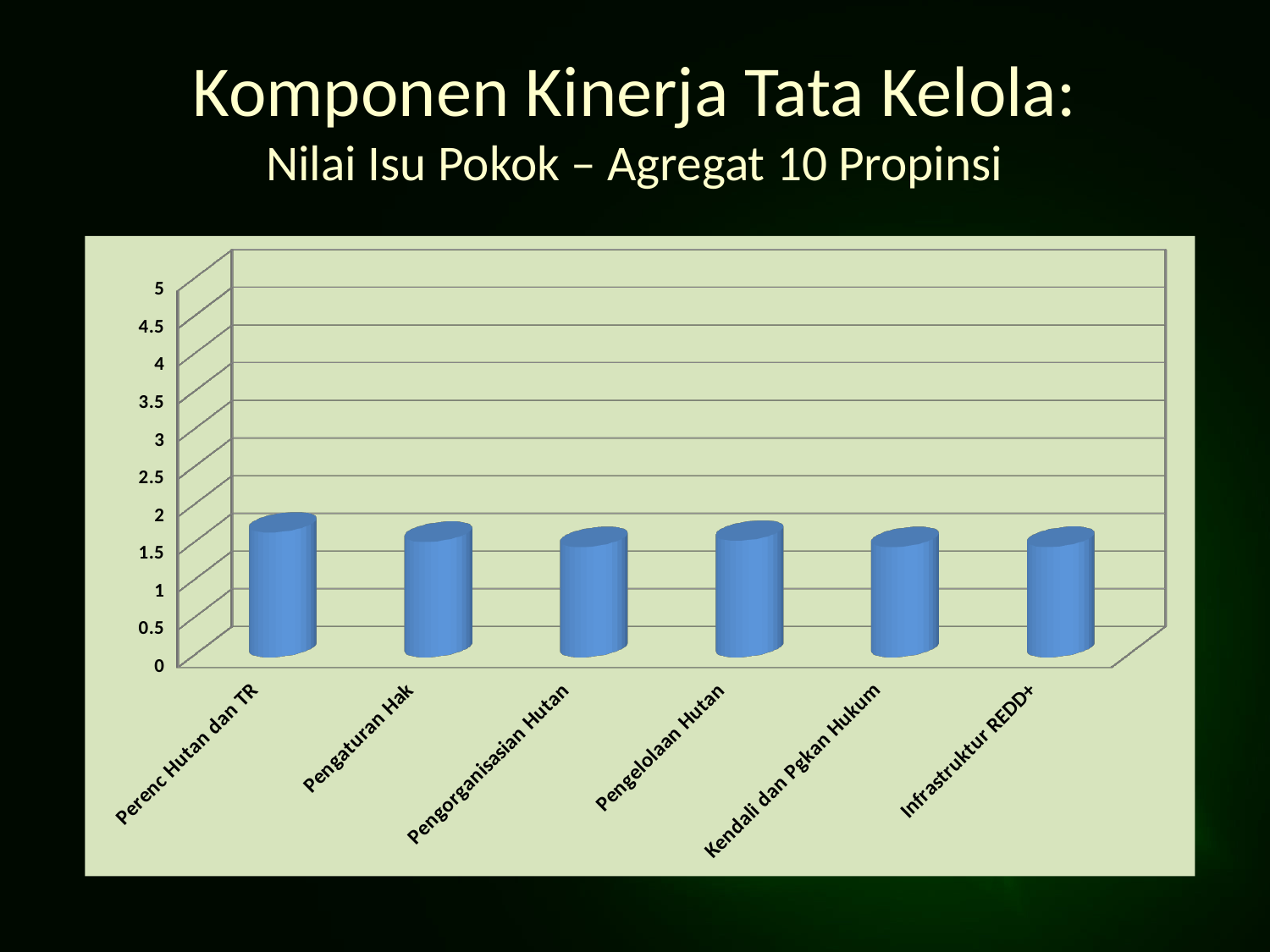
Is the value for Kendali dan Pgkan Hukum greater or less than 1? greater Which category has the highest bar in the chart? Perenc Hutan dan TR Is the value for Pengelolaan Hutan greater or less than 2? less Is the value for Infrastruktur REDD+ greater or less than 2.5? less What is the highest value shown on the vertical axis of the chart? 5 Which is larger, the value for Perenc Hutan dan TR or the value for Infrastruktur REDD+? Perenc Hutan dan TR What kind of chart is shown on the slide? bar chart How many categories are shown on the x axis of the chart? 6